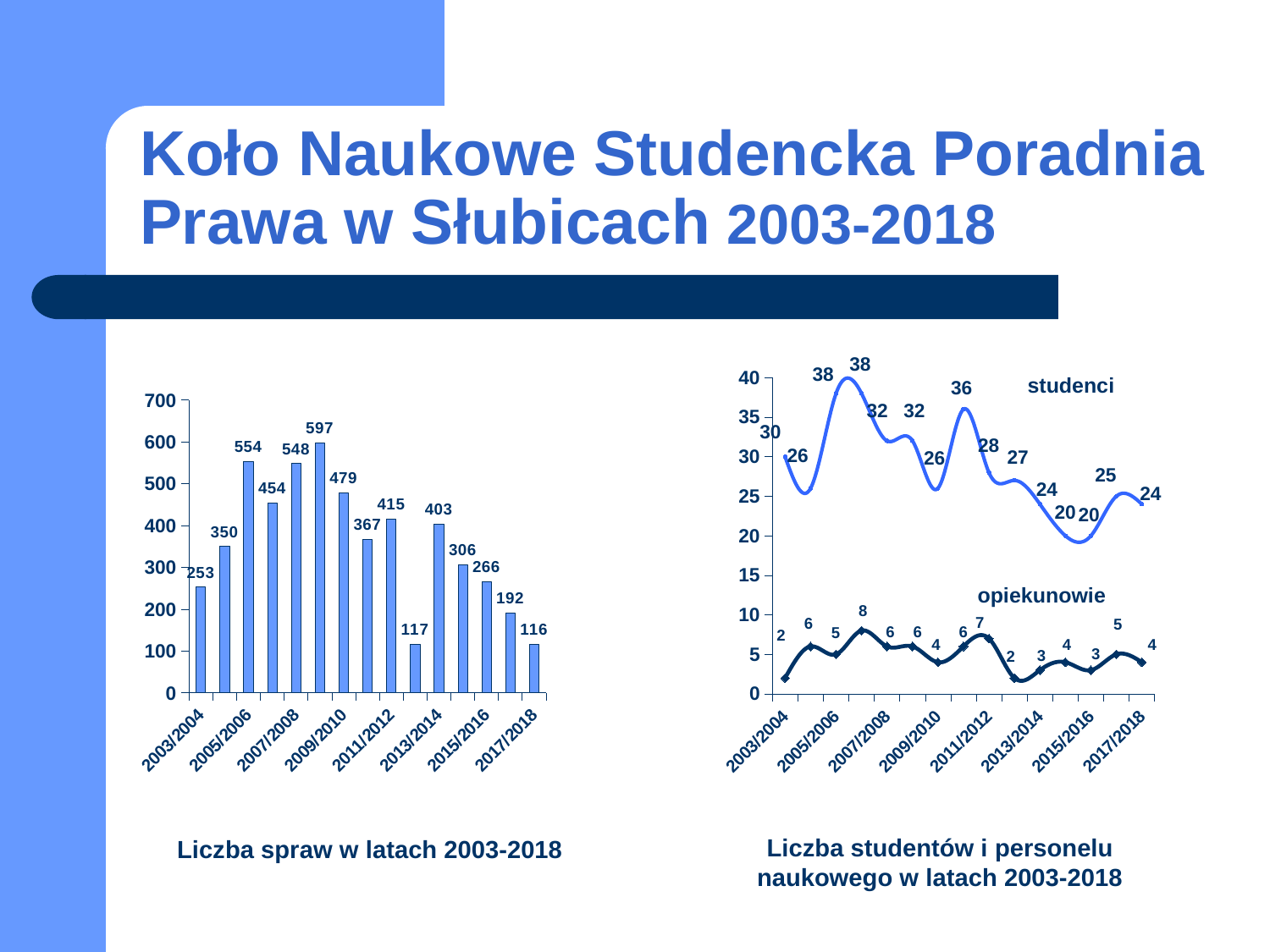
In the left chart 'Liczba spraw w latach 2003-2018', what is the highest value shown? 597 In the right chart 'Liczba studentów i personelu naukowego w latach 2003-2018', what is the 'studenci' value for 2003/2004? 30 In the left chart 'Liczba spraw w latach 2003-2018', what is the value for 2003/2004? 253 In the left chart 'Liczba spraw w latach 2003-2018', which labelled year has the lowest value? 2017/2018 In the right chart 'Liczba studentów i personelu naukowego w latach 2003-2018', what is the highest value of the 'opiekunowie' series? 8 In the left chart 'Liczba spraw w latach 2003-2018', what is the difference between the values for 2005/2006 and 2007/2008? 6 In the right chart 'Liczba studentów i personelu naukowego w latach 2003-2018', what is the difference between the 'studenci' and 'opiekunowie' values for 2017/2018? 20 In the left chart 'Liczba spraw w latach 2003-2018', which is larger: the value for 2009/2010 or for 2011/2012? 2009/2010 What kind of chart is the left chart, 'Liczba spraw w latach 2003-2018'? bar chart In the right chart 'Liczba studentów i personelu naukowego w latach 2003-2018', what is the 'opiekunowie' value for 2017/2018? 4 How many series are plotted in the right chart 'Liczba studentów i personelu naukowego w latach 2003-2018'? 2 How many bars are in the left chart 'Liczba spraw w latach 2003-2018'? 15